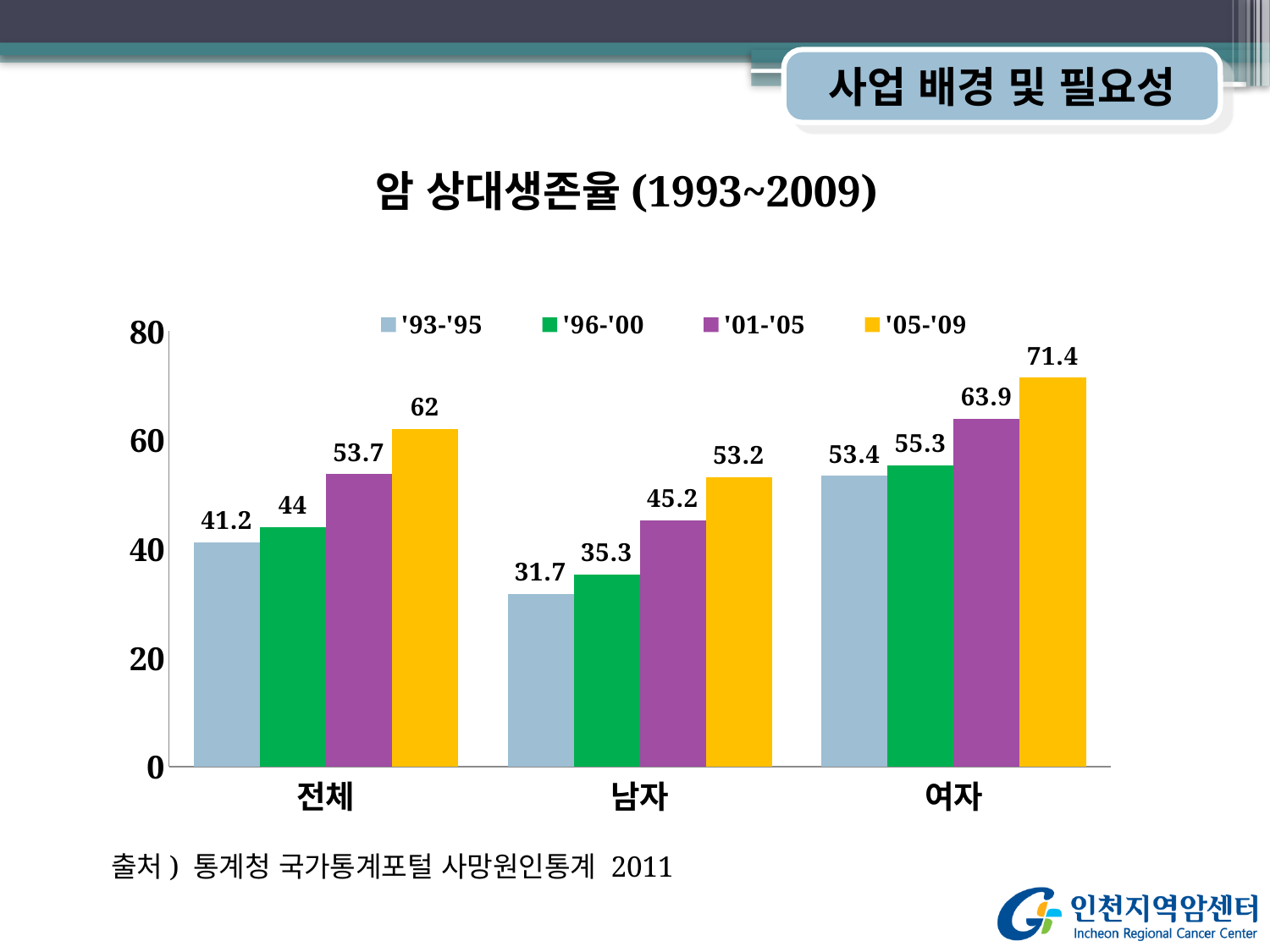
What is the difference between the '05-'09 and '93-'95 values for 여자? 18 What kind of chart is shown on the slide? bar chart How many series does the legend list? 4 What is the difference between the '01-'05 values for 여자 and 남자? 18.7 Which category has the highest value in the '05-'09 series? 여자 What is the title of the chart? 암 상대생존율 (1993~2009) How many categories are shown on the x axis? 3 What is the value for 여자 in the '01-'05 series? 63.9 Which is larger: the '96-'00 value for 전체 or the '05-'09 value for 남자? '05-'09 value for 남자 Which category has the lowest value in the '96-'00 series? 남자 What is the value for 남자 in the '93-'95 series? 31.7 What is the value for 전체 in the '05-'09 series? 62